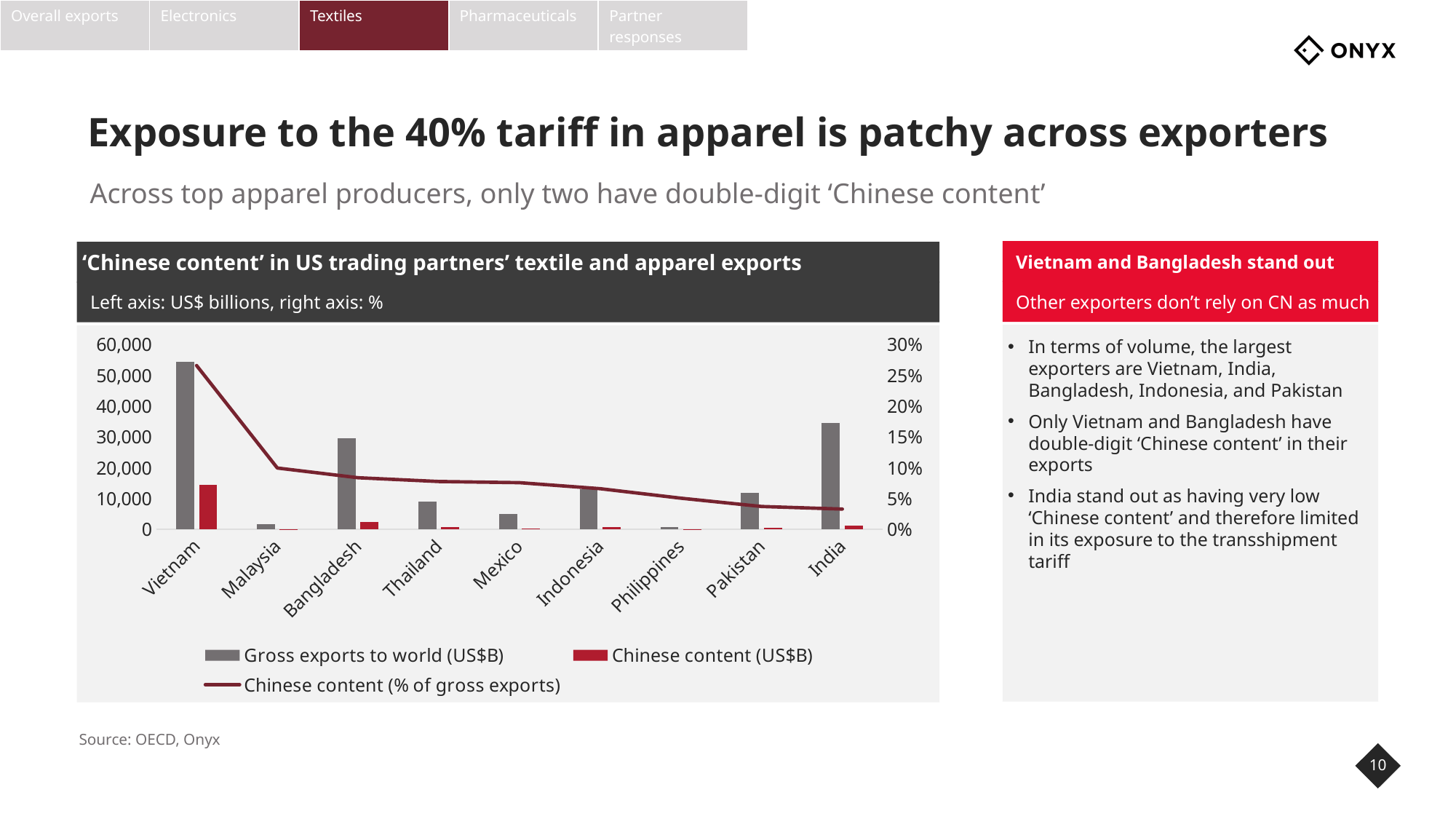
Is the value of gross exports to world for Vietnam greater or less than 50,000? greater How many series does the chart legend list? 3 What kind of chart is used to show 'Chinese content' in US trading partners' textile and apparel exports? Bar chart with a line Is the value of gross exports to world for India greater or less than 30,000? greater How many countries are shown on the x axis of the chart? 9 Is the Chinese content (% of gross exports) for India greater or less than 5%? less Which country has the highest gross exports to world (US$B)? Vietnam Which country has the highest Chinese content as a % of gross exports? Vietnam Which has larger gross exports to world, India or Bangladesh? India Which country has the lowest Chinese content as a % of gross exports? India What does the left axis of the chart measure? US$ billions Does the Chinese content (% of gross exports) line generally rise or fall from Vietnam to India? Fall